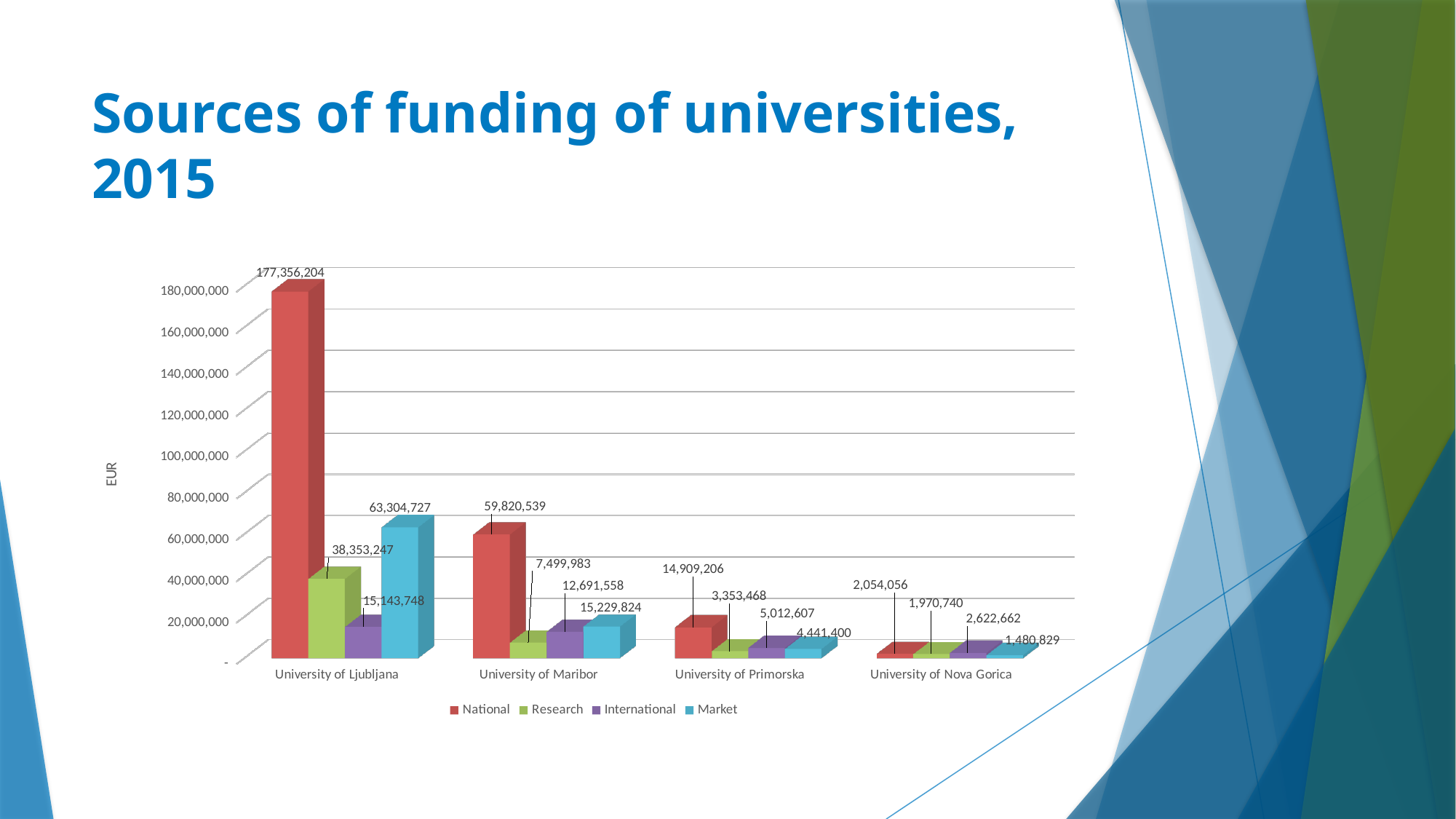
What is the Market funding value for the University of Maribor? 15,229,824 How many universities are shown on the x axis? 4 Which university has the lowest Market funding? University of Nova Gorica What kind of chart is shown on the slide? Bar chart What is the difference between Market and International funding for the University of Maribor? 2,538,266 How many series does the legend list? 4 Which university has the highest National funding? University of Ljubljana What is the International funding value for the University of Nova Gorica? 2,622,662 For the University of Primorska, which is larger: International or Market funding? International What is the Research funding value for the University of Primorska? 3,353,468 What is the National funding value for the University of Ljubljana? 177,356,204 What is the difference between National and Market funding for the University of Ljubljana? 114,051,477